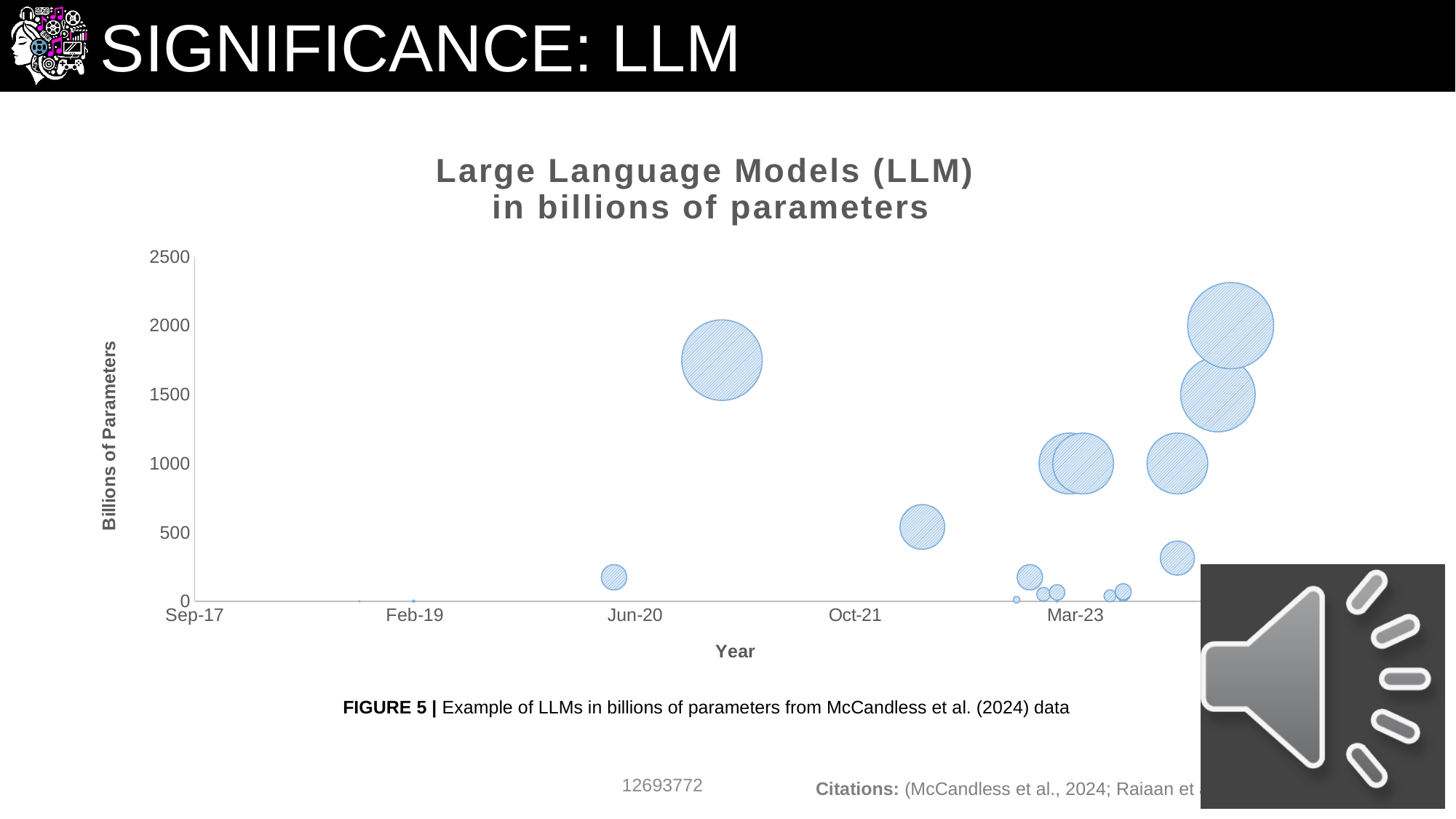
Is the value for the large bubble located between Jun-20 and Oct-21 greater or less than 2000? less What is the label of the vertical axis of the chart? Billions of Parameters Is the value for the bubble located just after Oct-21 greater or less than 1000? less Do the bubble values generally rise or fall as the year increases along the x axis? rise What is the title of the chart? Large Language Models (LLM) in billions of parameters Is the value for the small bubble located just after Jun-20 greater or less than 500? less What kind of chart is shown on the slide? bubble chart